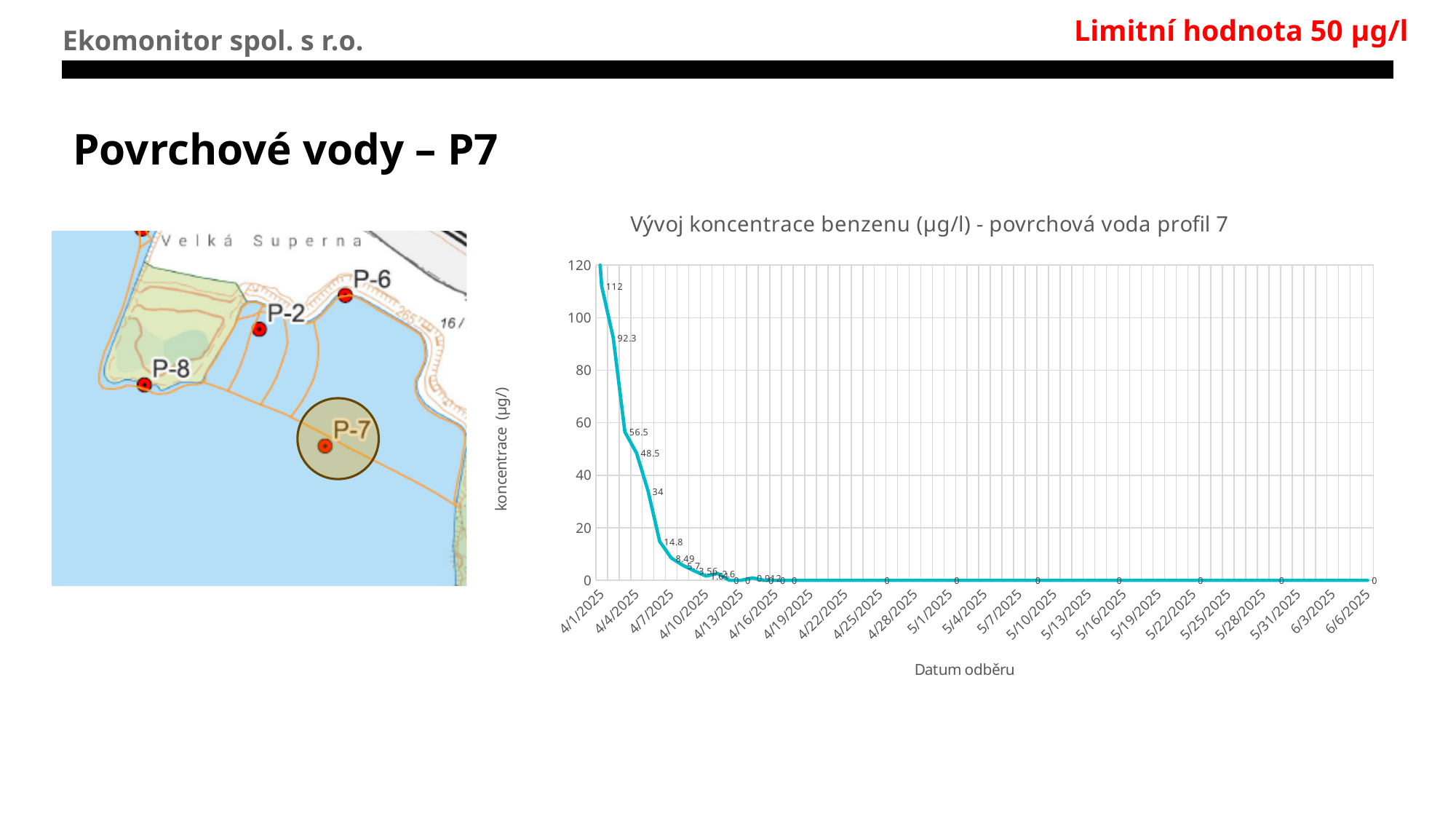
What is the label of the y axis? koncentrace (µg/l) Is the value for 6/6/2025 greater or less than 20? less Is the value for 4/1/2025 greater or less than 100? greater What is the benzene concentration on 4/1/2025? 112 Which is larger, the value on 4/1/2025 or the value on 6/6/2025? 4/1/2025 What is the difference between the first labelled value (112) and the second labelled value (92.3)? 19.7 What type of chart is shown on the slide? line chart What is the lowest labelled value on the chart? 0 What is the highest labelled value on the chart? 112 How many date labels are shown on the x axis? 23 What is the title of the chart? Vývoj koncentrace benzenu (µg/l) - povrchová voda profil 7 Do the values rise or fall along the x axis from 4/1/2025 onward? fall